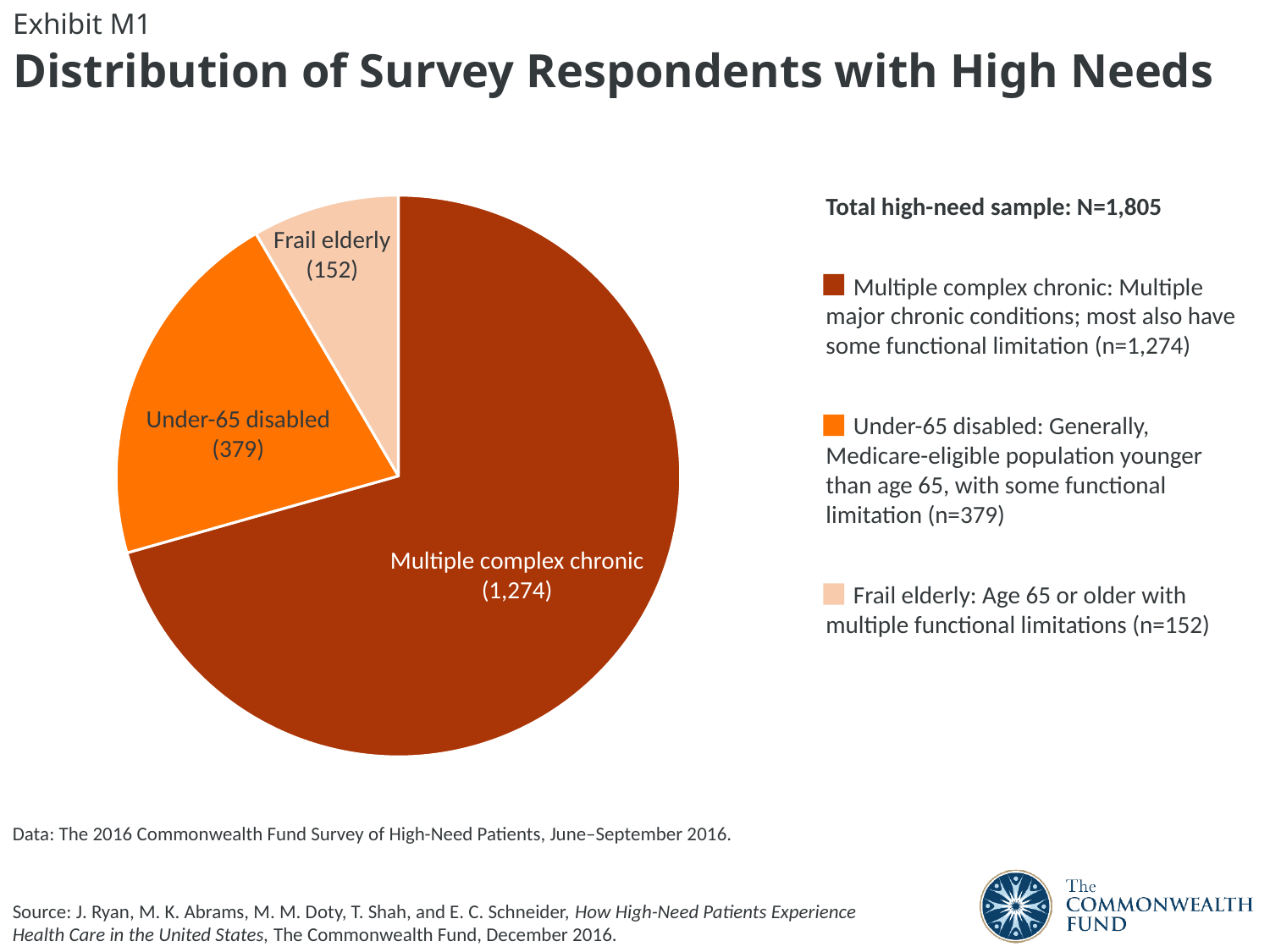
Which group has the smallest number of respondents? Frail elderly Which group has the largest number of respondents? Multiple complex chronic What is the number of respondents in the Frail elderly group? 152 How many slices does the pie chart have? 3 What is the total high-need sample size shown on the slide? N=1,805 How many more respondents are in the Under-65 disabled group than in the Frail elderly group? 227 Which group is larger, Under-65 disabled or Frail elderly? Under-65 disabled What is the number of respondents in the Under-65 disabled group? 379 What colour is the Under-65 disabled slice of the pie chart? Orange What is the number of respondents in the Multiple complex chronic group? 1,274 What is the difference between the Multiple complex chronic group and the Under-65 disabled group? 895 What kind of chart is shown on the slide? Pie chart